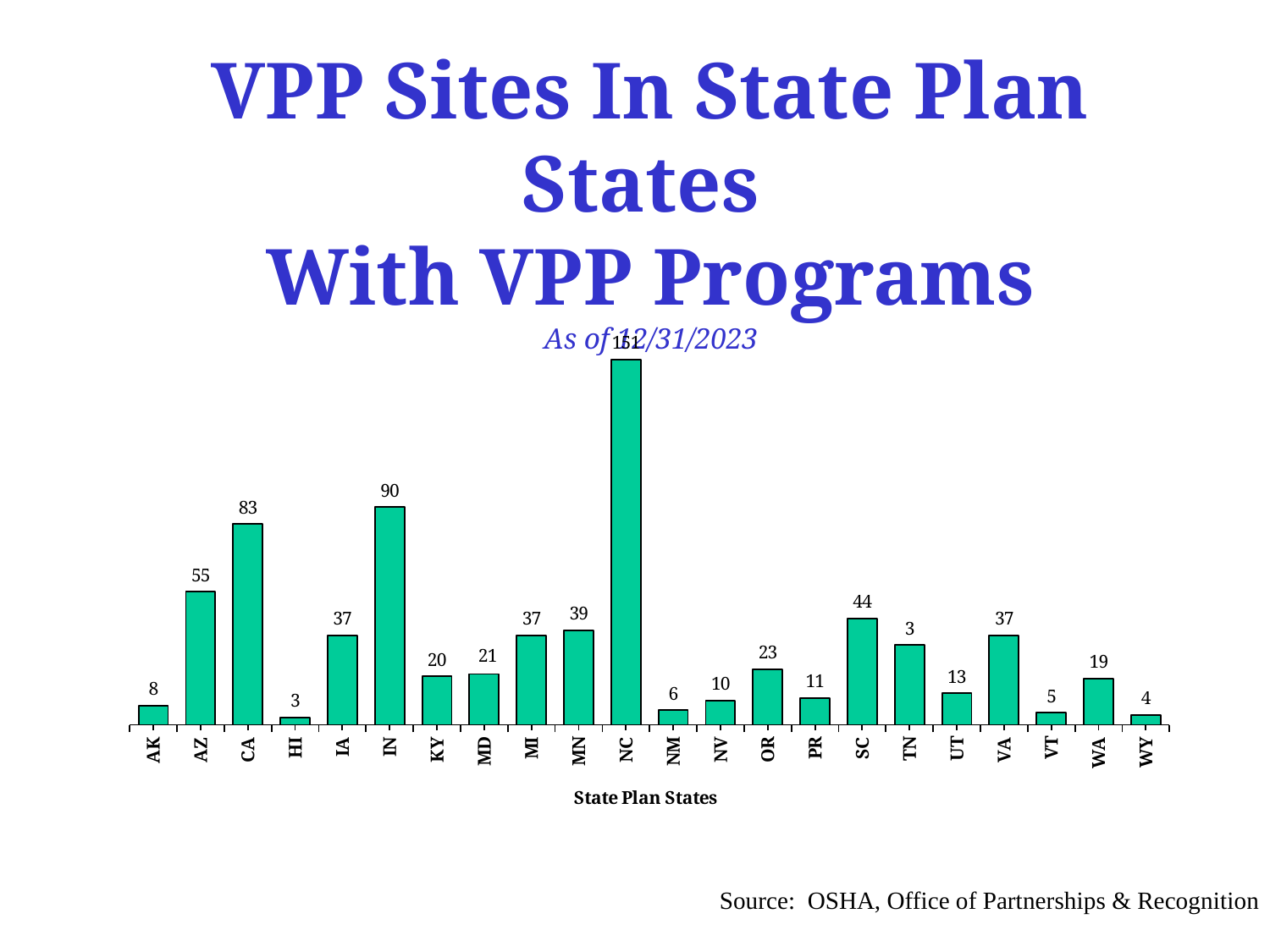
How many VPP sites does CA have? 83 What is the value shown for WA? 19 Which state has the highest number of VPP sites? NC Which has a larger value, AZ or SC? AZ Which has a larger value, IN or CA? IN What is the value shown for IN? 90 What is the x-axis title of the chart? State Plan States What kind of chart is shown on the slide? Bar chart What is the value shown for SC? 44 What is the difference between the values for CA and AZ? 28 What is the difference between the values for SC and OR? 21 How many states are shown on the x axis? 22